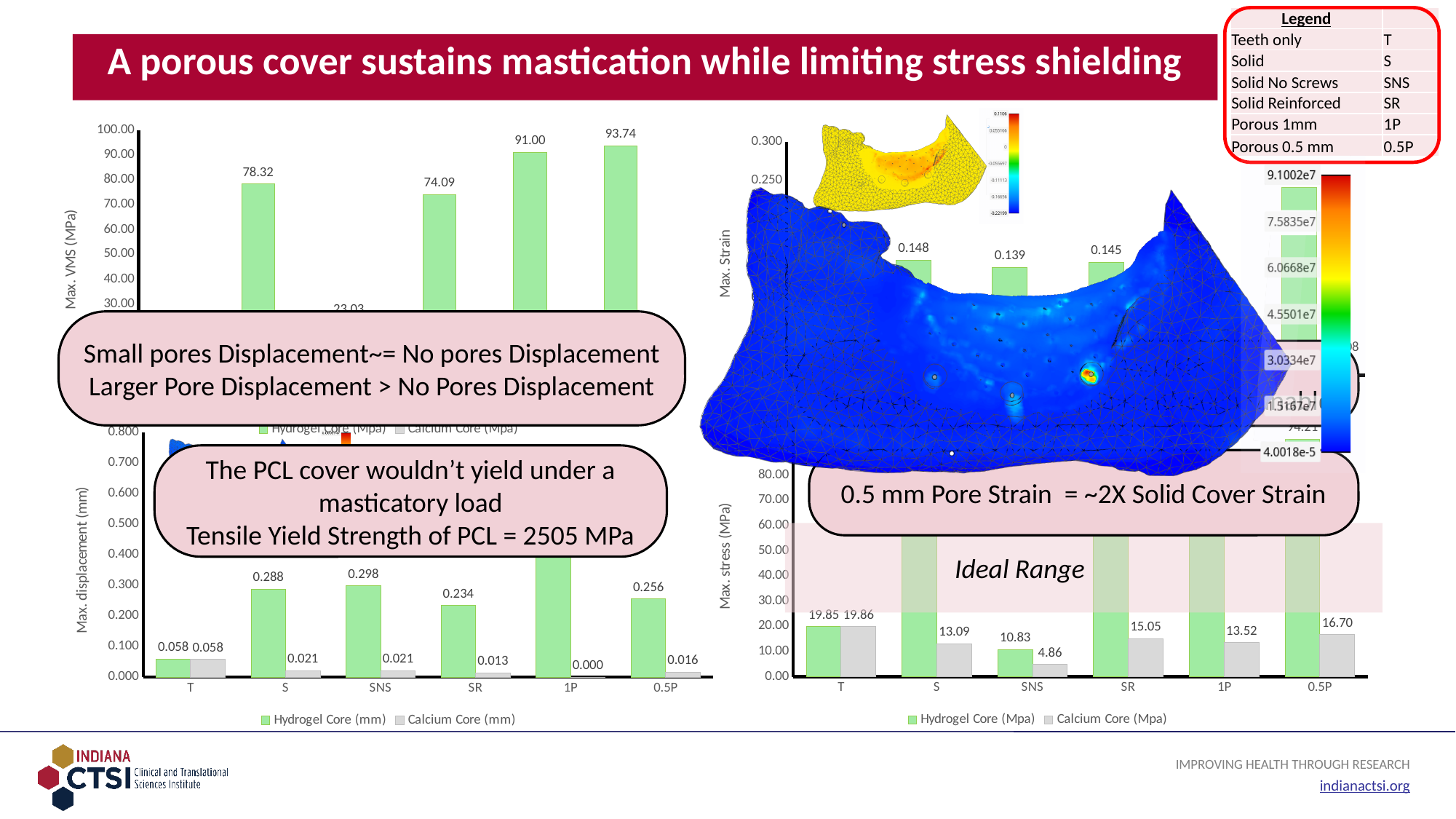
On the Max. stress (MPa) chart, what is the Hydrogel Core value for T? 19.85 On the Max. displacement (mm) chart, how many series does the legend list? 2 On the Max. stress (MPa) chart, which category has the lowest Calcium Core value? SNS On the Max. displacement (mm) chart, is the Hydrogel Core value for 1P greater or less than 0.400? greater On the Max. displacement (mm) chart, what is the Calcium Core value for 1P? 0.000 On the Max. displacement (mm) chart, what is the difference between the Hydrogel Core values for S and SR? 0.054 On the Max. stress (MPa) chart, what is the Calcium Core value for SNS? 4.86 On the Max. displacement (mm) chart, what is the Calcium Core value for SR? 0.013 On the Max. displacement (mm) chart, what is the Hydrogel Core value for SNS? 0.298 On the Max. stress (MPa) chart, how many categories are shown on the x axis? 6 What is the largest data label shown on the Max. VMS (MPa) chart? 93.74 On the Max. stress (MPa) chart, is the Hydrogel Core value for S greater or less than 50.00? greater